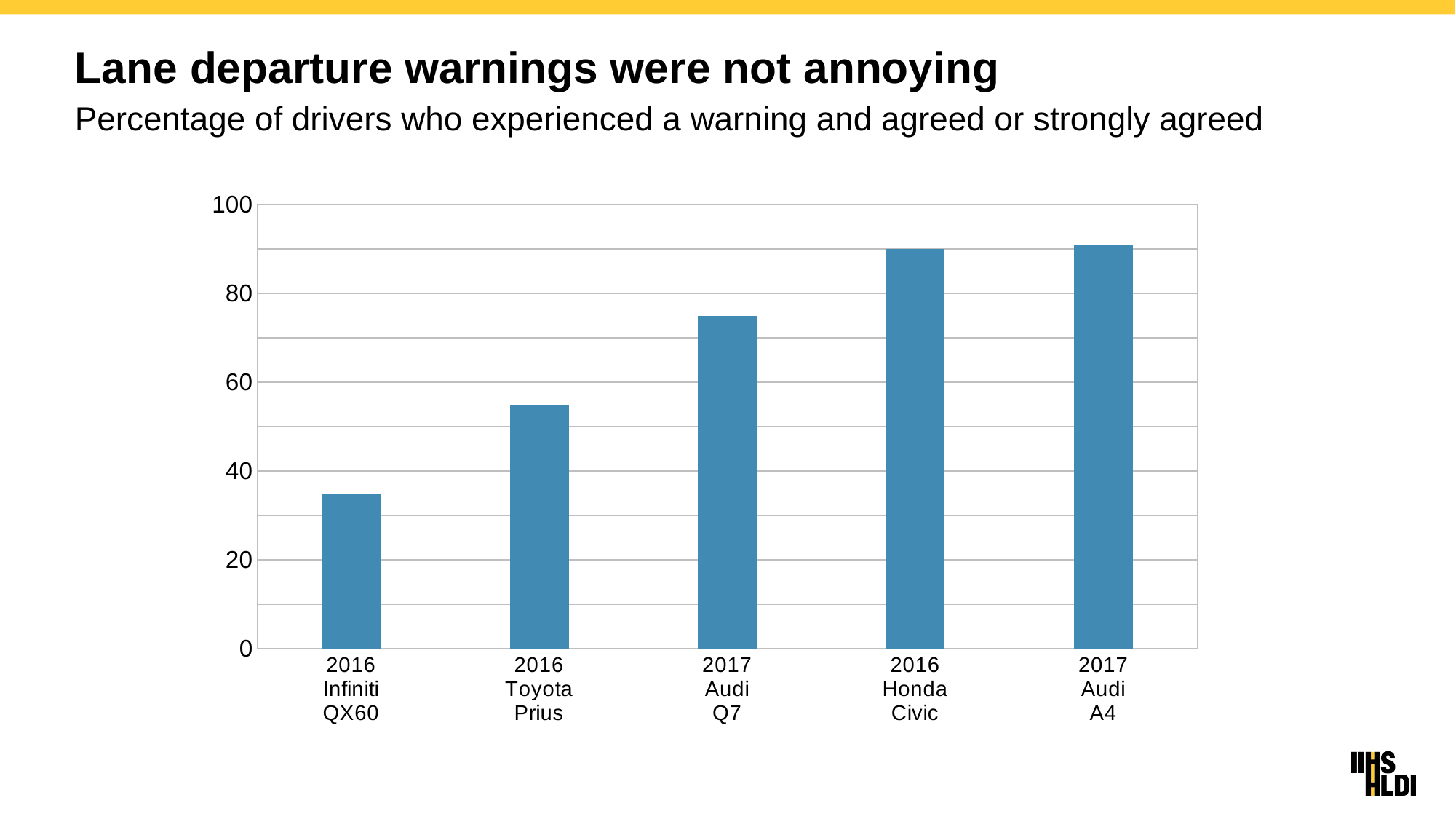
Is the value for the 2017 Audi A4 greater or less than 100? less Is the value for the 2016 Toyota Prius greater or less than 40? greater What is the title of the slide? Lane departure warnings were not annoying What kind of chart is shown on the slide? bar chart Which vehicle has the lowest percentage of drivers who agreed or strongly agreed? 2016 Infiniti QX60 Do the values rise or fall moving from left to right across the chart? rise How many vehicle models are shown on the chart? 5 Is the value for the 2016 Toyota Prius greater or less than 60? less Which has a higher value, the 2017 Audi Q7 or the 2016 Toyota Prius? 2017 Audi Q7